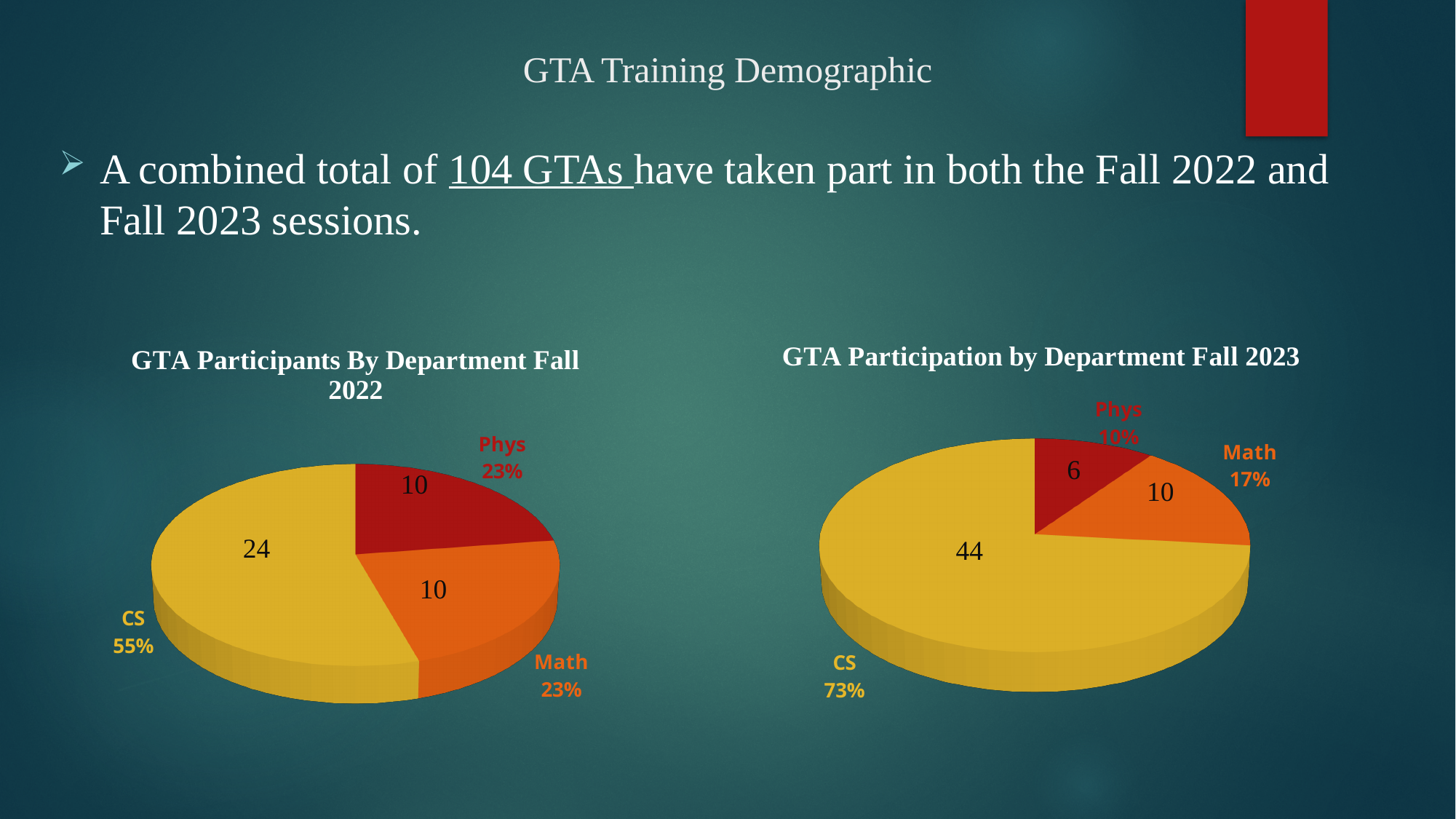
In the 'GTA Participation by Department Fall 2023' chart, what share of the pie does Math represent? 17% In the 'GTA Participants By Department Fall 2022' chart, what value is shown for CS? 24 How many slices does the 'GTA Participants By Department Fall 2022' chart have? 3 In the 'GTA Participation by Department Fall 2023' chart, what is the difference between the CS value and the Math value? 34 In the 'GTA Participation by Department Fall 2023' chart, what value is shown for CS? 44 In the 'GTA Participation by Department Fall 2023' chart, which department has the smallest slice? Phys In the 'GTA Participants By Department Fall 2022' chart, which department has the largest slice? CS In the 'GTA Participation by Department Fall 2023' chart, what value is shown for Phys? 6 What kind of chart is the 'GTA Participation by Department Fall 2023' chart? Pie chart In the 'GTA Participants By Department Fall 2022' chart, what value is shown for Math? 10 In the 'GTA Participation by Department Fall 2023' chart, which is larger, the Math value or the Phys value? Math In the 'GTA Participants By Department Fall 2022' chart, what share of the pie does CS represent? 55%